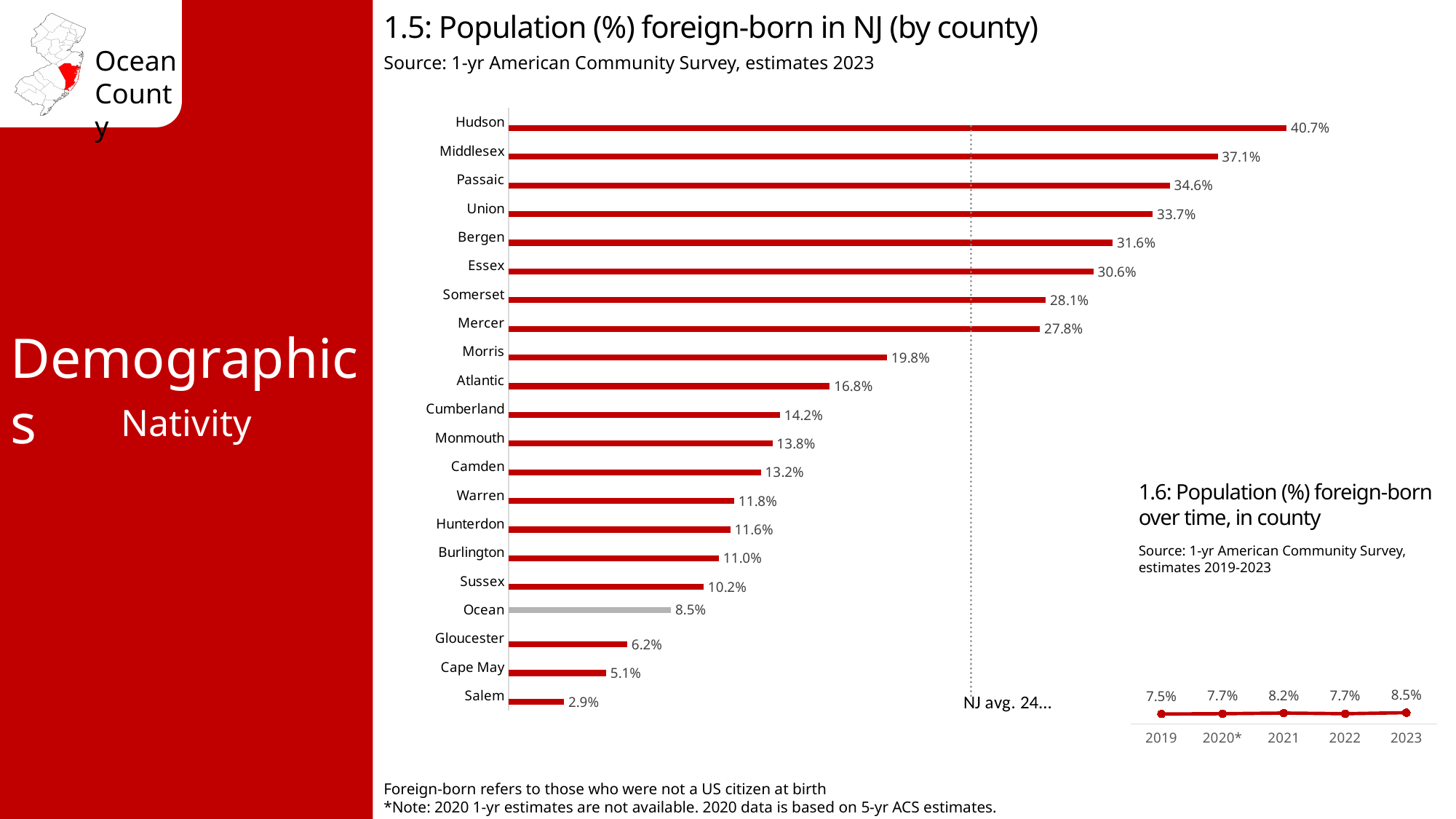
In chart 1.5 (Population (%) foreign-born in NJ by county), which county's bar is coloured grey instead of red? Ocean In chart 1.5 (Population (%) foreign-born in NJ by county), what is the value for Middlesex? 37.1% In chart 1.5 (Population (%) foreign-born in NJ by county), which county has the highest value? Hudson In chart 1.5 (Population (%) foreign-born in NJ by county), which county has the lowest value? Salem In chart 1.6 (Population (%) foreign-born over time, in county), which year has the highest value? 2023 In chart 1.5 (Population (%) foreign-born in NJ by county), how many counties are shown? 21 In chart 1.6 (Population (%) foreign-born over time, in county), what is the value for 2021? 8.2% In chart 1.5 (Population (%) foreign-born in NJ by county), what is the difference between Hudson and Ocean? 32.2% In chart 1.5 (Population (%) foreign-born in NJ by county), what is the value for Ocean? 8.5% In chart 1.5 (Population (%) foreign-born in NJ by county), which is larger, Monmouth or Camden? Monmouth In chart 1.6 (Population (%) foreign-born over time, in county), what is the difference between 2023 and 2019? 1.0% What kind of chart is chart 1.5 (Population (%) foreign-born in NJ by county)? Bar chart